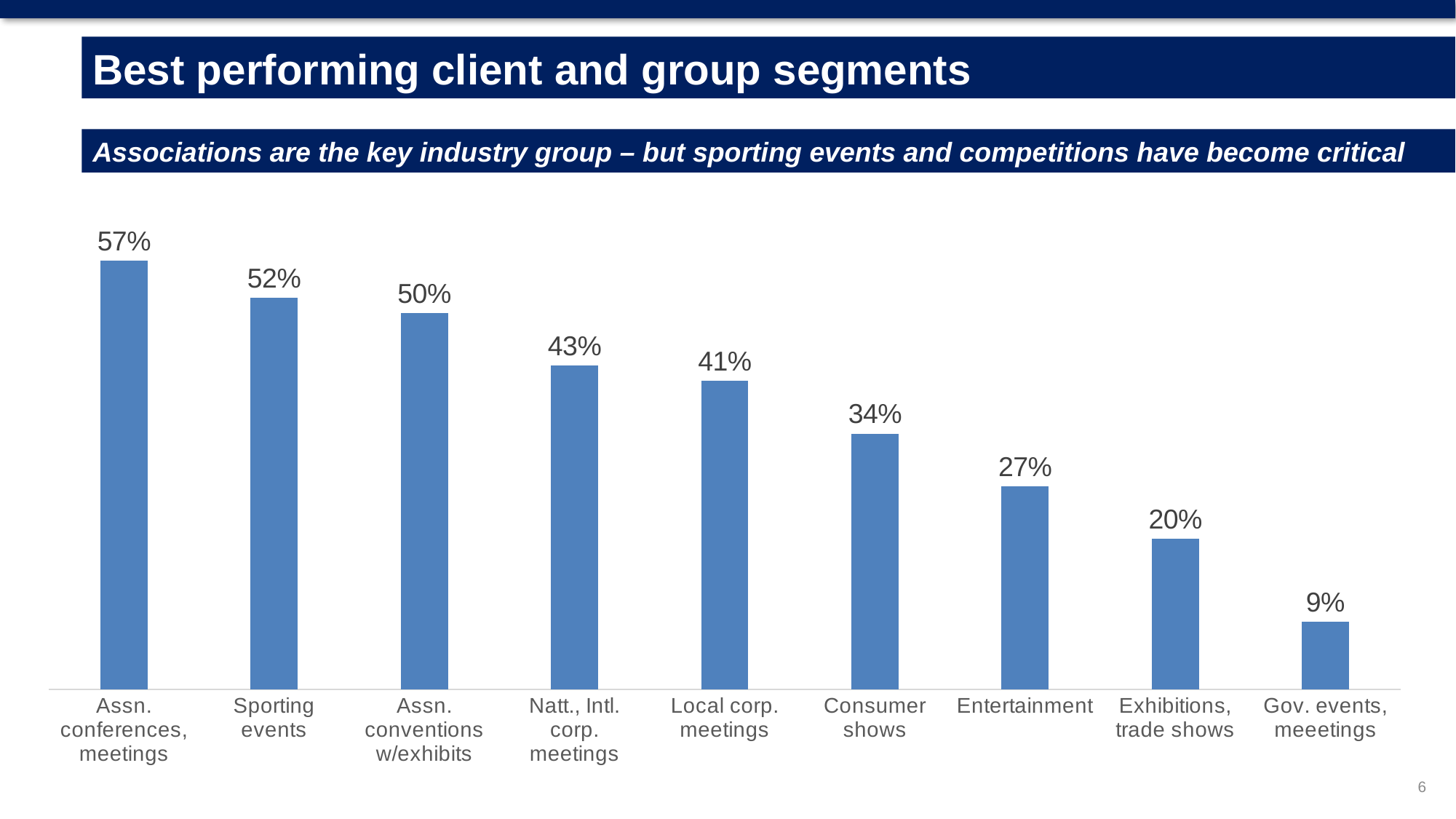
Do the values rise or fall from left to right along the x axis? Fall What is the value for Entertainment? 27% Which category has the lowest value? Gov. events, meeetings Which is larger, the value for Local corp. meetings or the value for Consumer shows? Local corp. meetings What is the difference between the values for Assn. conferences, meetings and Assn. conventions w/exhibits? 7% What is the value for Sporting events? 52% What is the difference between the values for Natt., Intl. corp. meetings and Exhibitions, trade shows? 23% What kind of chart is shown on the slide? Bar chart Which category has the highest value? Assn. conferences, meetings How many categories are shown in the chart? 9 What is the value for Gov. events, meeetings? 9% What is the value for Consumer shows? 34%